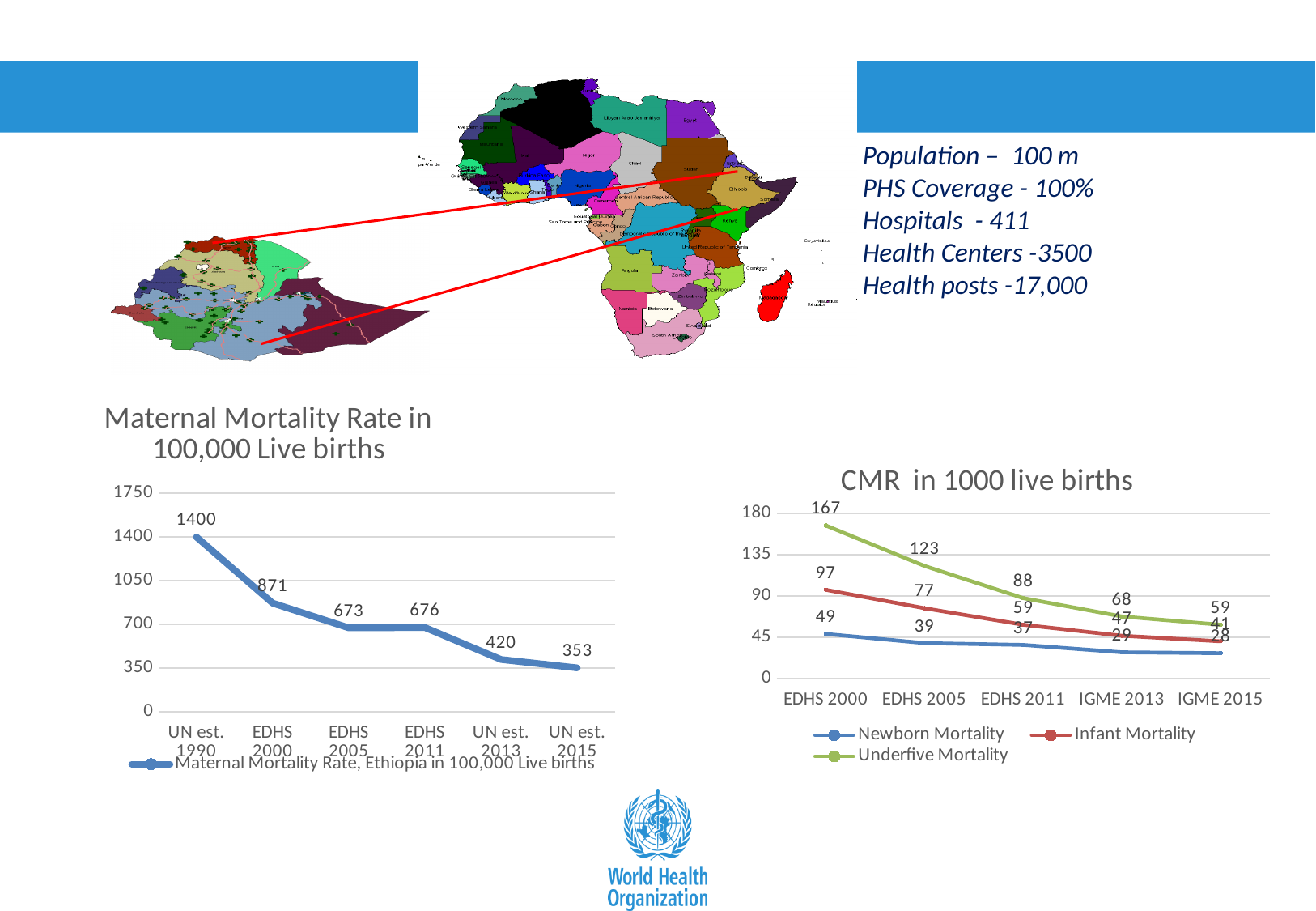
In the CMR in 1000 live births chart, what is the Infant Mortality value for IGME 2015? 41 In the Maternal Mortality Rate chart, which category has the lowest value? UN est. 2015 In the CMR in 1000 live births chart, which is larger for IGME 2013: Infant Mortality or Newborn Mortality? Infant Mortality In the Maternal Mortality Rate chart, how many data points are plotted? 6 In the Maternal Mortality Rate chart, what is the value for EDHS 2011? 676 In the Maternal Mortality Rate chart, do the values generally rise or fall from left to right? fall What type of chart is the CMR in 1000 live births chart? line chart In the Maternal Mortality Rate chart, what is the difference between the EDHS 2000 value and the UN est. 2013 value? 451 In the CMR in 1000 live births chart, what is the difference between Underfive Mortality and Newborn Mortality for EDHS 2000? 118 In the CMR in 1000 live births chart, what is the Underfive Mortality value for EDHS 2011? 88 In the Maternal Mortality Rate chart, what is the value for UN est. 1990? 1400 In the CMR in 1000 live births chart, how many series does the legend list? 3